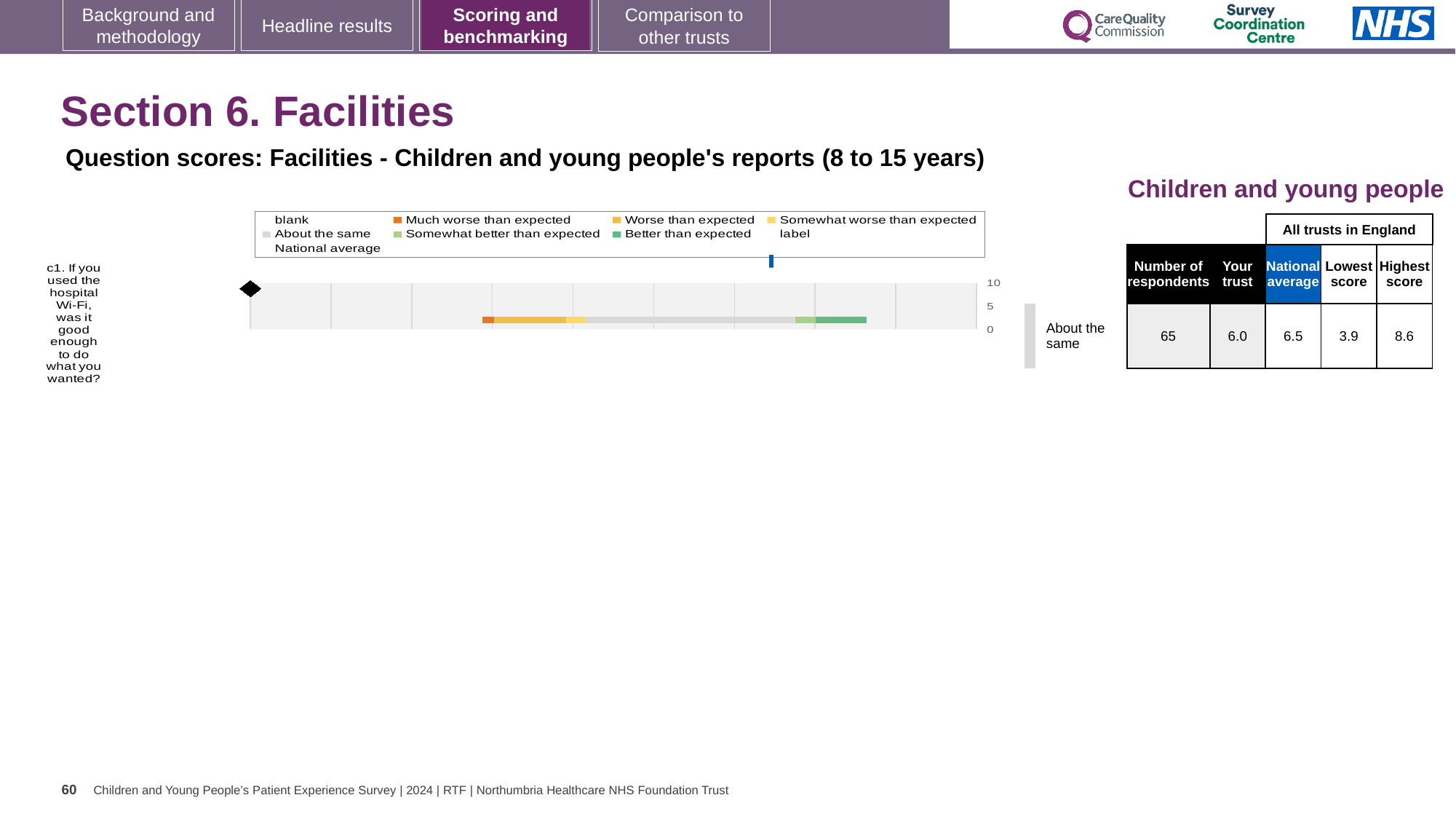
In the table beside the chart, what is the highest score among all trusts in England for question c1? 8.6 What kind of chart is shown on the slide? bar chart Which survey question is plotted in the chart? c1. If you used the hospital Wi-Fi, was it good enough to do what you wanted? How many survey questions are plotted in the chart? 1 In the table beside the chart, how many respondents answered question c1? 65 Is the national average marker for question c1 greater or less than 5? greater In the table beside the chart, what is the lowest score among all trusts in England for question c1? 3.9 For question c1, which is larger: the 'Your trust' score or the national average? National average In the table beside the chart, what is the national average score for question c1? 6.5 In the table beside the chart, what is the 'Your trust' score for question c1? 6.0 What benchmark category is the trust's result for question c1 placed in? About the same For question c1, what is the difference between the highest score and the lowest score among all trusts in England? 4.7